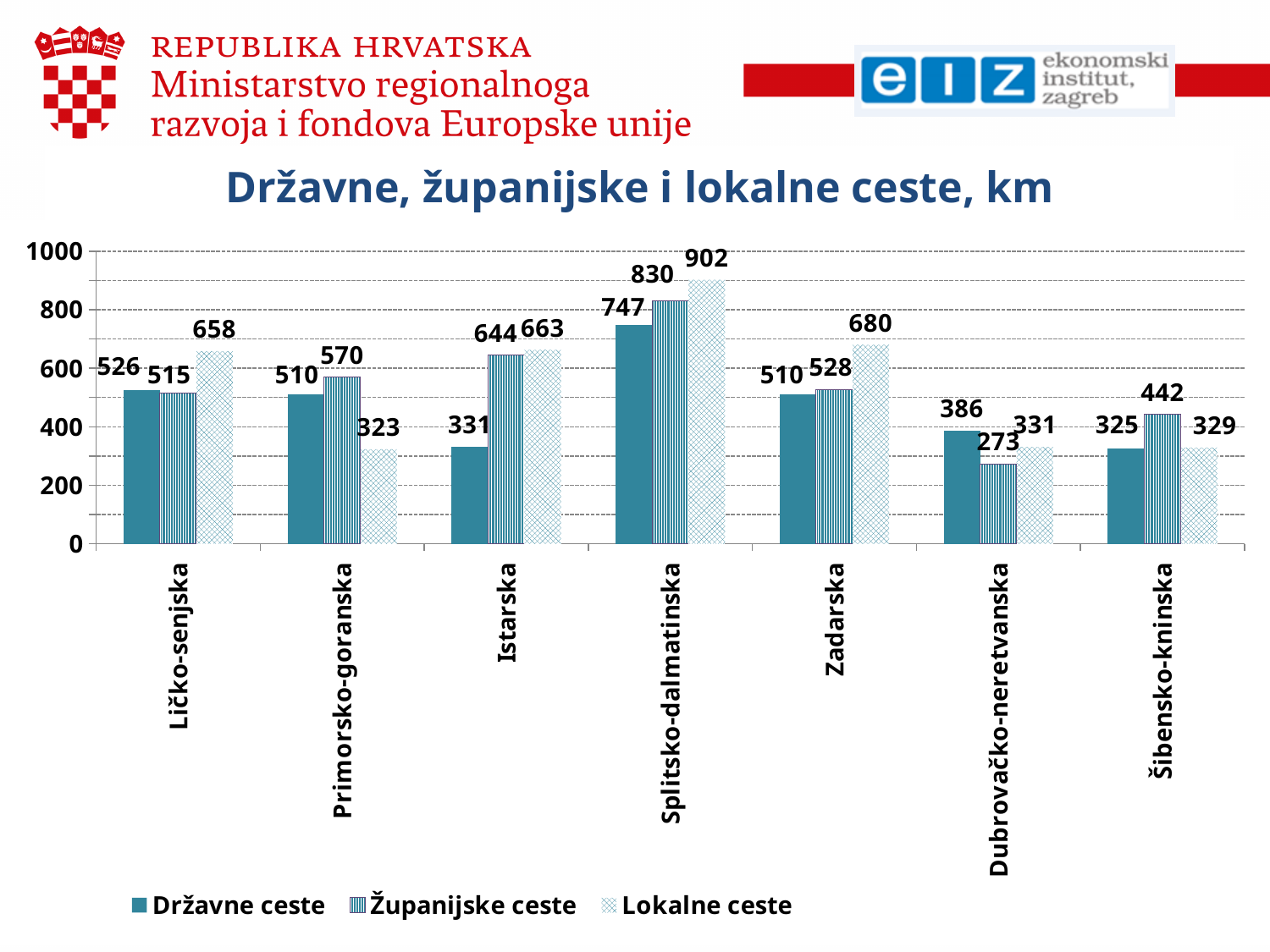
What is the title of the chart? Državne, županijske i lokalne ceste, km What is the value of Državne ceste for Splitsko-dalmatinska? 747 What kind of chart is shown on the slide? bar chart How many series does the legend list? 3 Which county has the lowest value for Državne ceste? Šibensko-kninska How many counties are shown on the x axis? 7 Which is larger for Zadarska: Državne ceste or Lokalne ceste? Lokalne ceste Which county has the highest value for Lokalne ceste? Splitsko-dalmatinska Is the value of Županijske ceste for Splitsko-dalmatinska greater or less than 800? greater What is the value of Županijske ceste for Dubrovačko-neretvanska? 273 What is the value of Lokalne ceste for Primorsko-goranska? 323 What is the difference between Lokalne ceste and Državne ceste for Istarska? 332